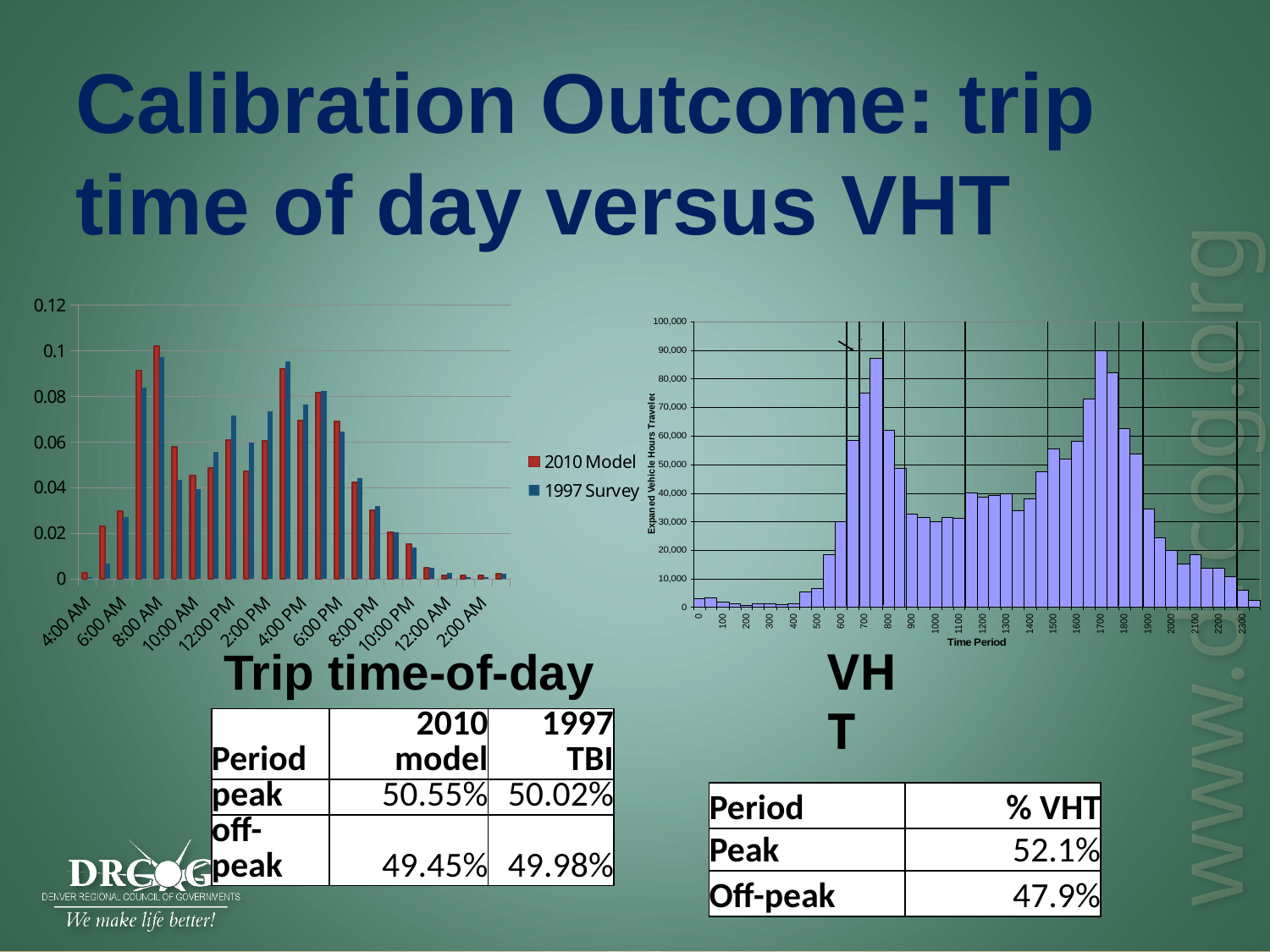
In the Trip time-of-day chart, is the 2010 Model value at 8:00 AM greater or less than 0.08? greater What kind of chart is the VHT chart on the right? bar chart How many series does the legend of the Trip time-of-day chart list? 2 In the VHT chart, is the value for time period 1700 greater or less than 80,000? greater What is the x-axis title of the VHT chart? Time Period In the Trip time-of-day chart, at which time of day does the 2010 Model series reach its highest value? 8:00 AM What kind of chart is the Trip time-of-day chart on the left? bar chart In the VHT chart, which time period has the highest value? 1700 What are the two series named in the legend of the Trip time-of-day chart? 2010 Model and 1997 Survey In the VHT chart, do the values rise or fall from time period 1700 to 2300? fall In the VHT chart, is the value for time period 1200 greater or less than 50,000? less